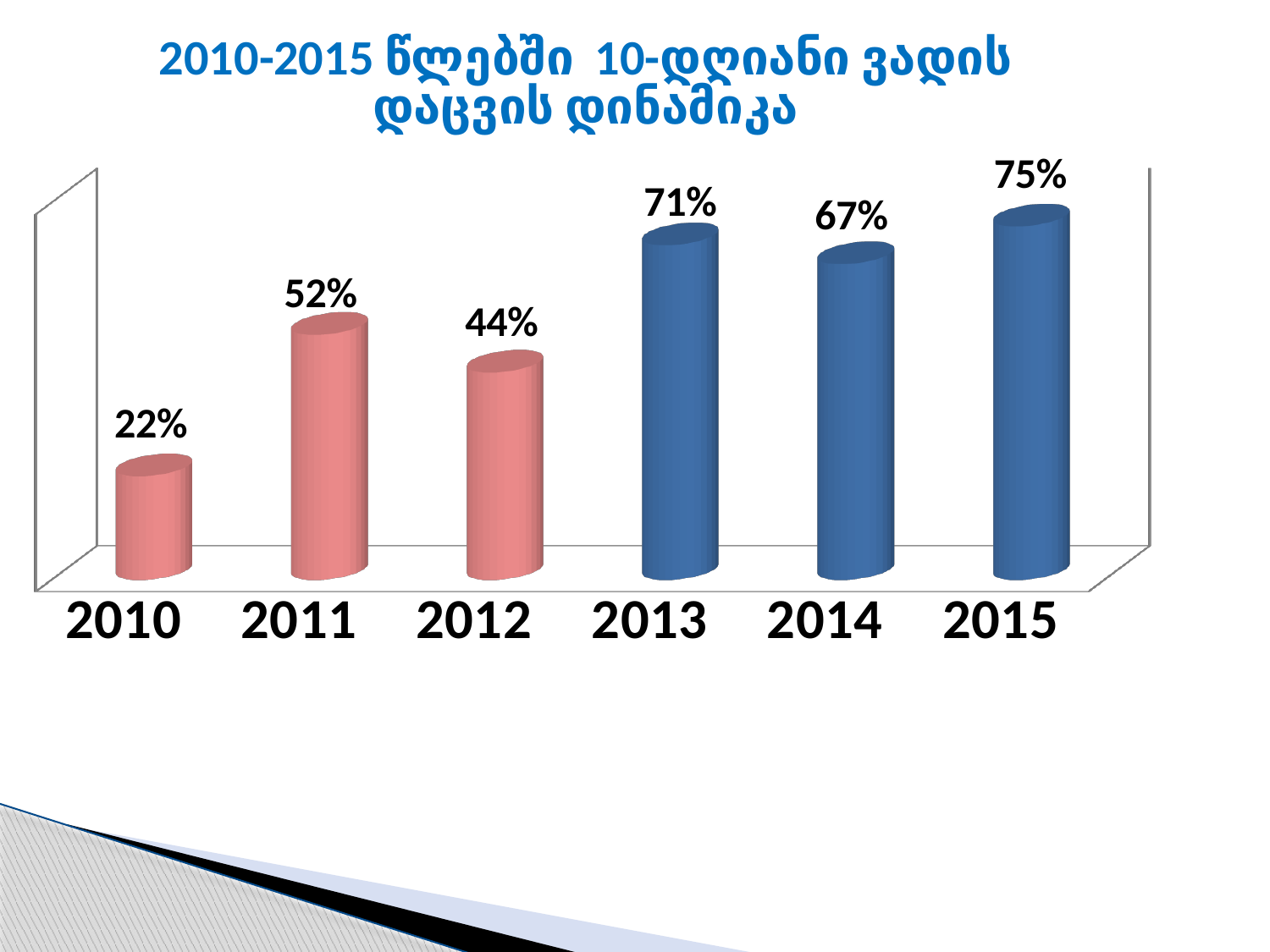
What is the value for 2010? 22% Which is larger, the value for 2013 or the value for 2014? 2013 What colour are the bars for 2013, 2014 and 2015? blue What is the value for 2014? 67% Do the values generally rise or fall from 2010 to 2015? rise What is the difference between the values for 2011 and 2012? 8% What is the value for 2013? 71% What kind of chart is this? bar chart What is the difference between the values for 2015 and 2010? 53% How many years are shown on the x axis? 6 Which year has the highest value? 2015 Which year has the lowest value? 2010